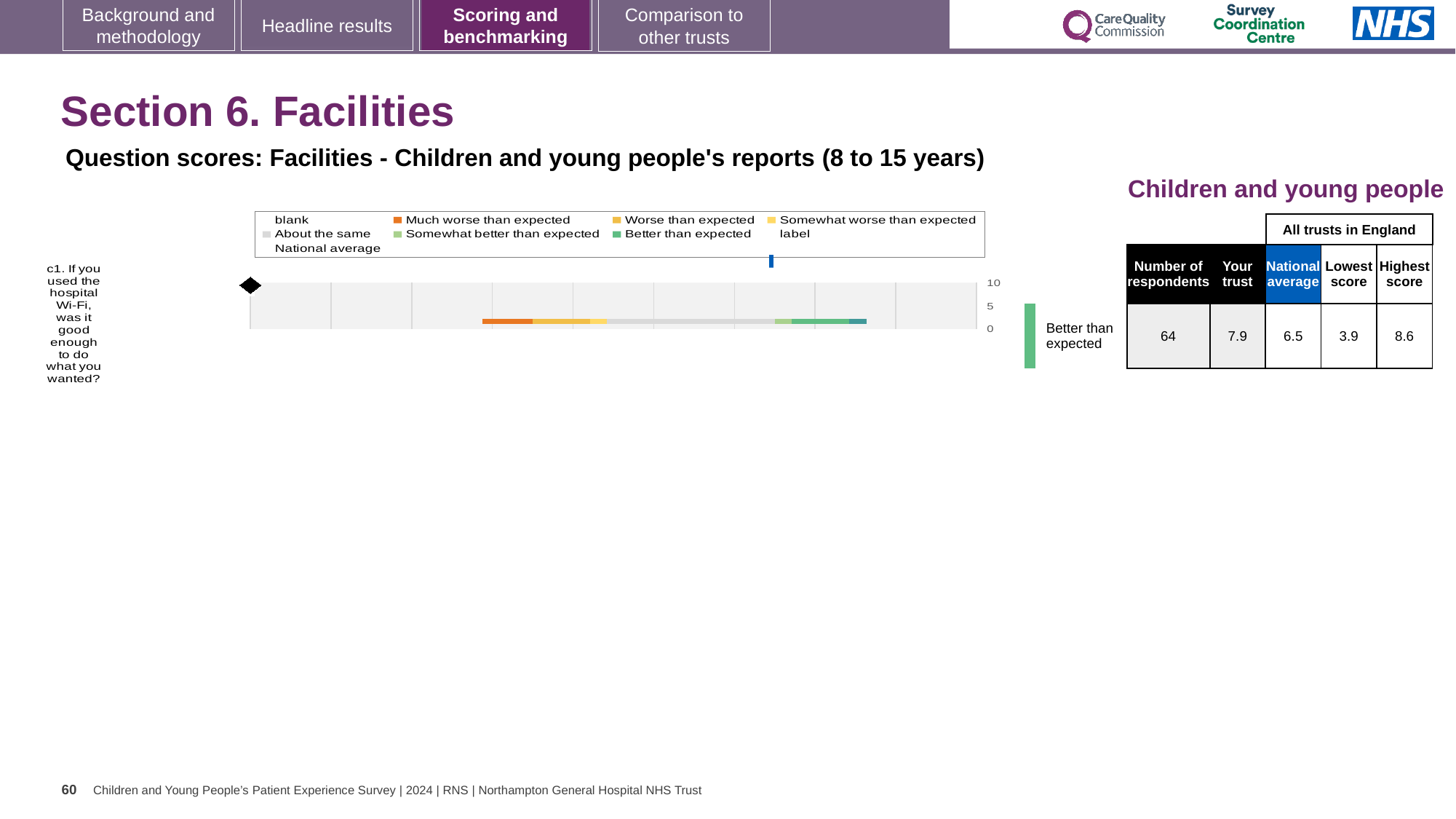
Which benchmarking category is the trust's score for c1 placed in? Better than expected What is the lowest score among all trusts in England for question c1? 3.9 What kind of chart is used to show the question score for c1? Bar chart How many respondents answered question c1? 64 By how much does the trust's score for c1 exceed the national average? 1.4 What is the difference between the highest and lowest scores for question c1? 4.7 What is the national average score for question c1? 6.5 What facility does question c1 on the chart ask about? Hospital Wi-Fi How many survey questions are plotted on the chart? 1 What is the highest score among all trusts in England for question c1? 8.6 What is the 'Your trust' score for question c1 (hospital Wi-Fi)? 7.9 Which is higher for question c1: the trust's score or the national average? Your trust